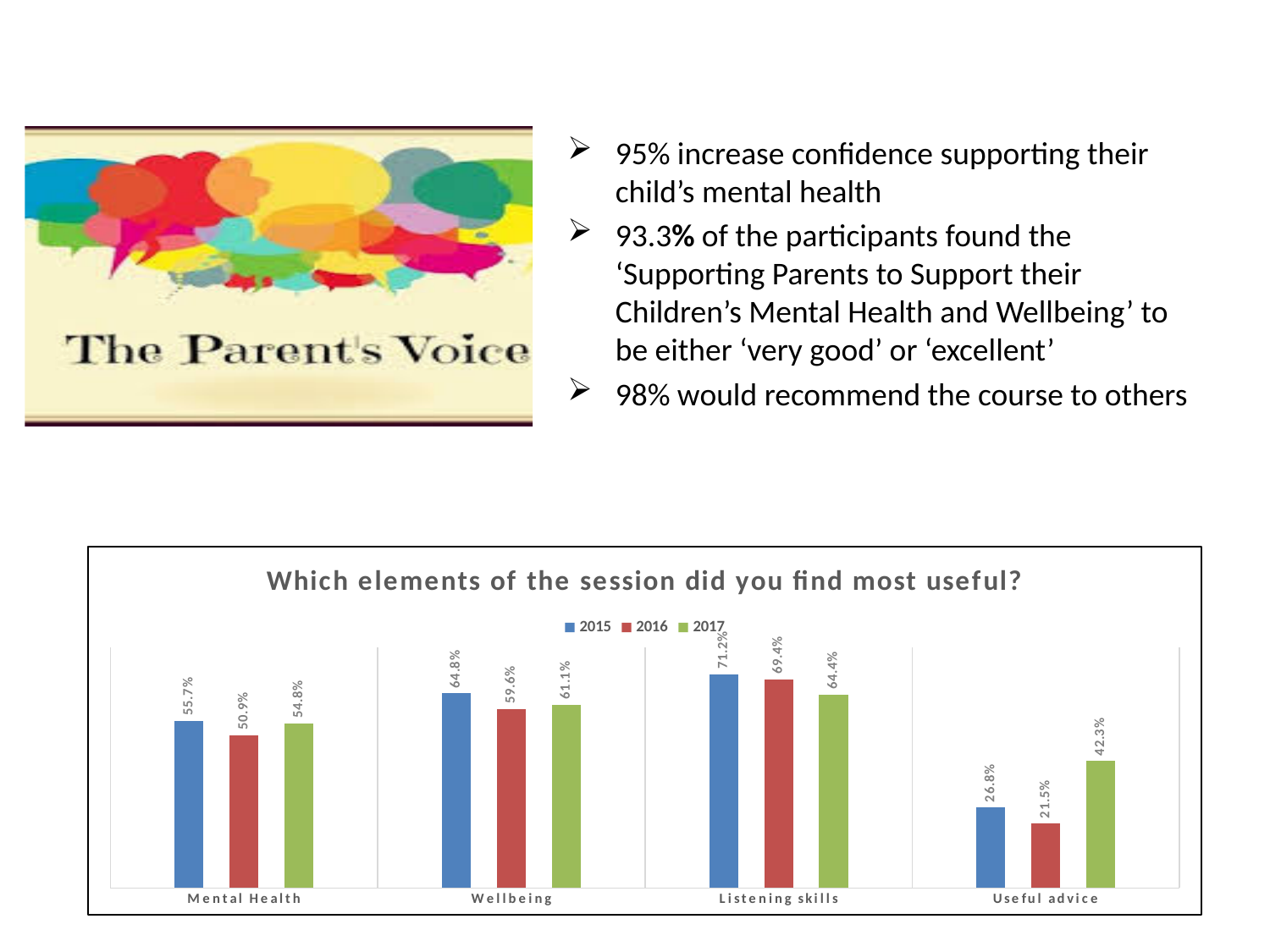
How many categories are shown on the x axis? 4 How many series does the legend list? 3 What is the value for Useful advice in 2017? 42.3% Which is larger, the 2015 value for Mental Health or the 2017 value for Mental Health? 2015 value for Mental Health Which category has the highest value in 2015? Listening skills What is the difference between the 2017 and 2016 values for Useful advice? 20.8% Which colour represents the 2017 series in the chart? Green Which category has the lowest value in 2016? Useful advice What kind of chart is shown on the slide? Bar chart What is the title of the chart? Which elements of the session did you find most useful? What is the value for Wellbeing in 2016? 59.6% What is the value for Listening skills in 2015? 71.2%